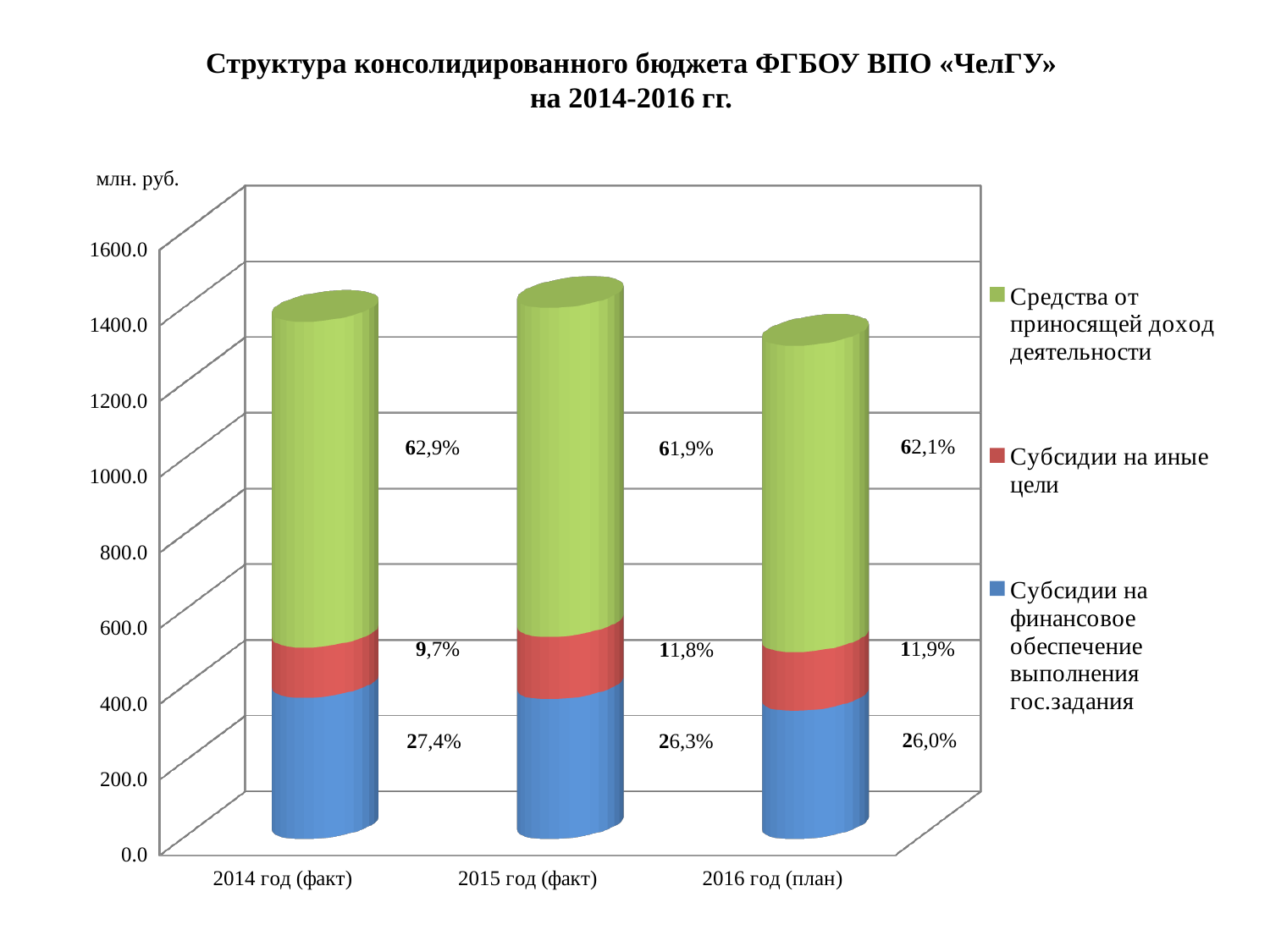
What share does «Субсидии на финансовое обеспечение выполнения гос.задания» have in the 2016 год (план) bar? 26,0% What share does «Субсидии на иные цели» have in the 2015 год (факт) bar? 11,8% Is the total height of the 2016 год (план) bar greater or less than 1400 млн. руб.? less How many years (categories) are shown on the x axis? 3 In which year is the share of «Субсидии на иные цели» the lowest? 2014 год (факт) What kind of chart is shown on the slide? stacked bar chart Does the share of «Субсидии на финансовое обеспечение выполнения гос.задания» rise or fall from 2014 to 2016? fall By how many percentage points does the share of «Средства от приносящей доход деятельности» in 2014 год (факт) exceed that in 2015 год (факт)? 1,0 Which is larger: the share of «Субсидии на финансовое обеспечение выполнения гос.задания» in 2014 год (факт) or in 2015 год (факт)? 2014 год (факт) In which year is the share of «Средства от приносящей доход деятельности» the highest? 2014 год (факт) What share does «Средства от приносящей доход деятельности» have in the 2014 год (факт) bar? 62,9% How many series does the legend list? 3